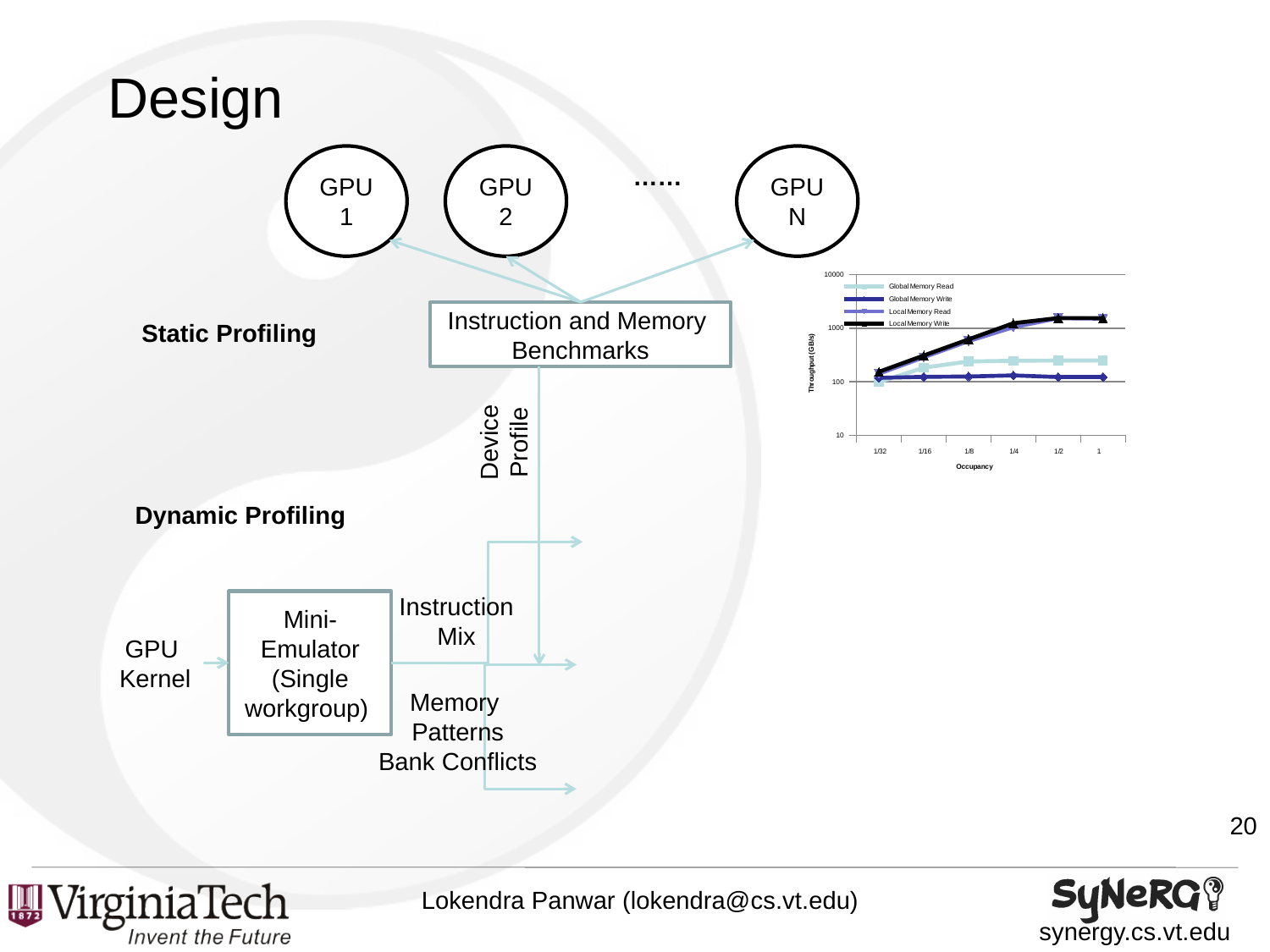
In the throughput chart, is the Global Memory Read value at occupancy 1 greater or less than 100? greater How many occupancy values are shown on the x axis of the throughput chart? 6 In the throughput chart, is the Global Memory Read value at occupancy 1 greater or less than 1000? less In the throughput chart, does the Local Memory Write throughput rise or fall as occupancy increases from 1/32 to 1? rise What is the label of the y axis of the throughput chart? Throughput (GB/s) How many series does the legend of the throughput chart list? 4 What kind of chart is shown on the right side of the slide? line chart In the throughput chart, which series has the lowest throughput at occupancy 1? Global Memory Write In the throughput chart, at occupancy 1, which is larger: Global Memory Read or Global Memory Write? Global Memory Read In the throughput chart, is the Local Memory Write value at occupancy 1/8 greater or less than 1000? less What is the label of the x axis of the throughput chart? Occupancy